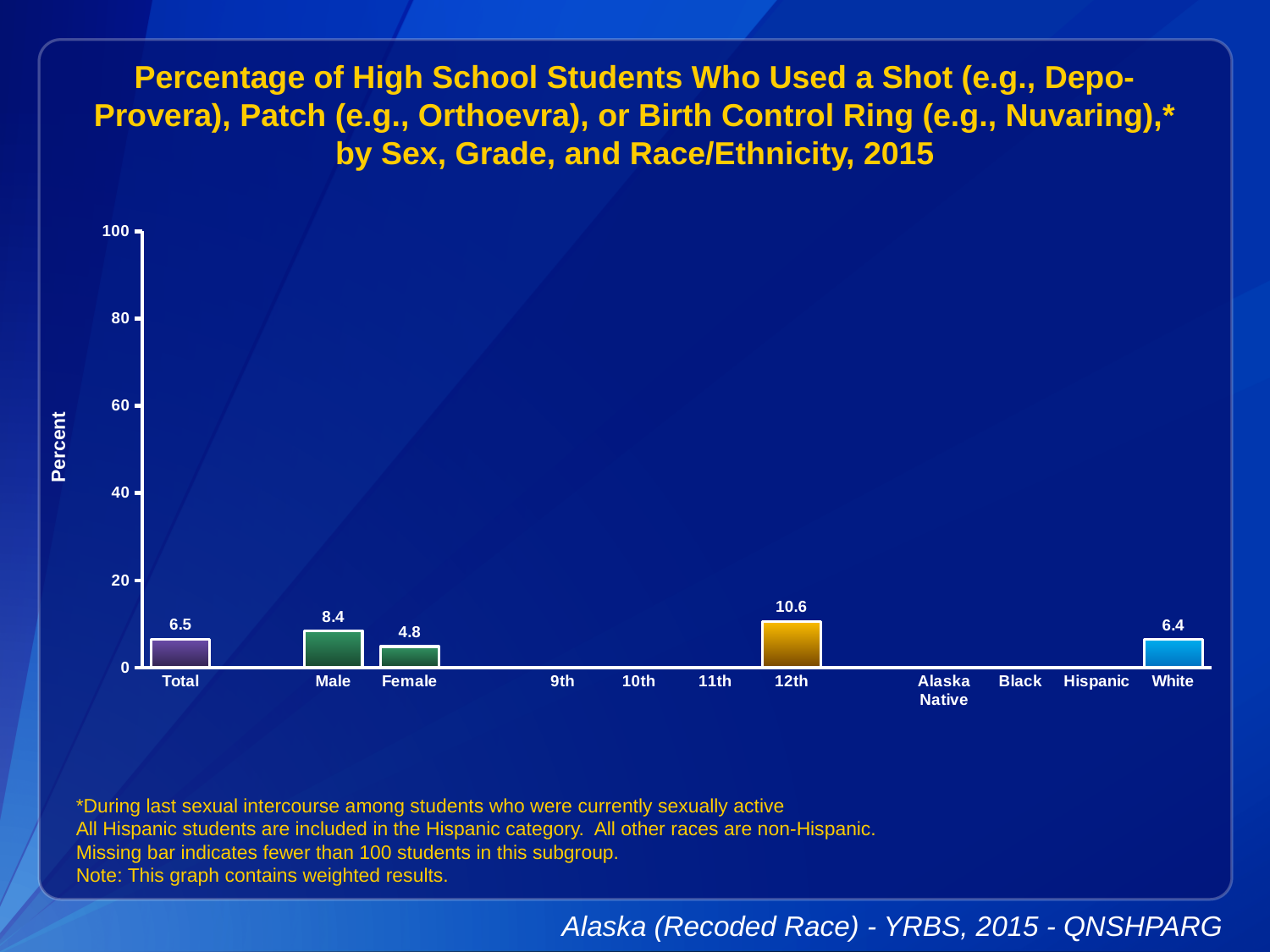
What is the value for 12th grade? 10.6 What is the value for Male? 8.4 Which is larger, the value for Total or the value for White? Total What is the value for White? 6.4 What kind of chart is shown on the slide? bar chart Is the value for 12th grade greater or less than 20? less What is the value for Female? 4.8 What is the value for Total? 6.5 What is the difference between the Male and Female values? 3.6 Which category has the highest value among the bars shown? 12th Which category has the lowest value among the bars shown? Female How many bars are plotted on the chart? 5